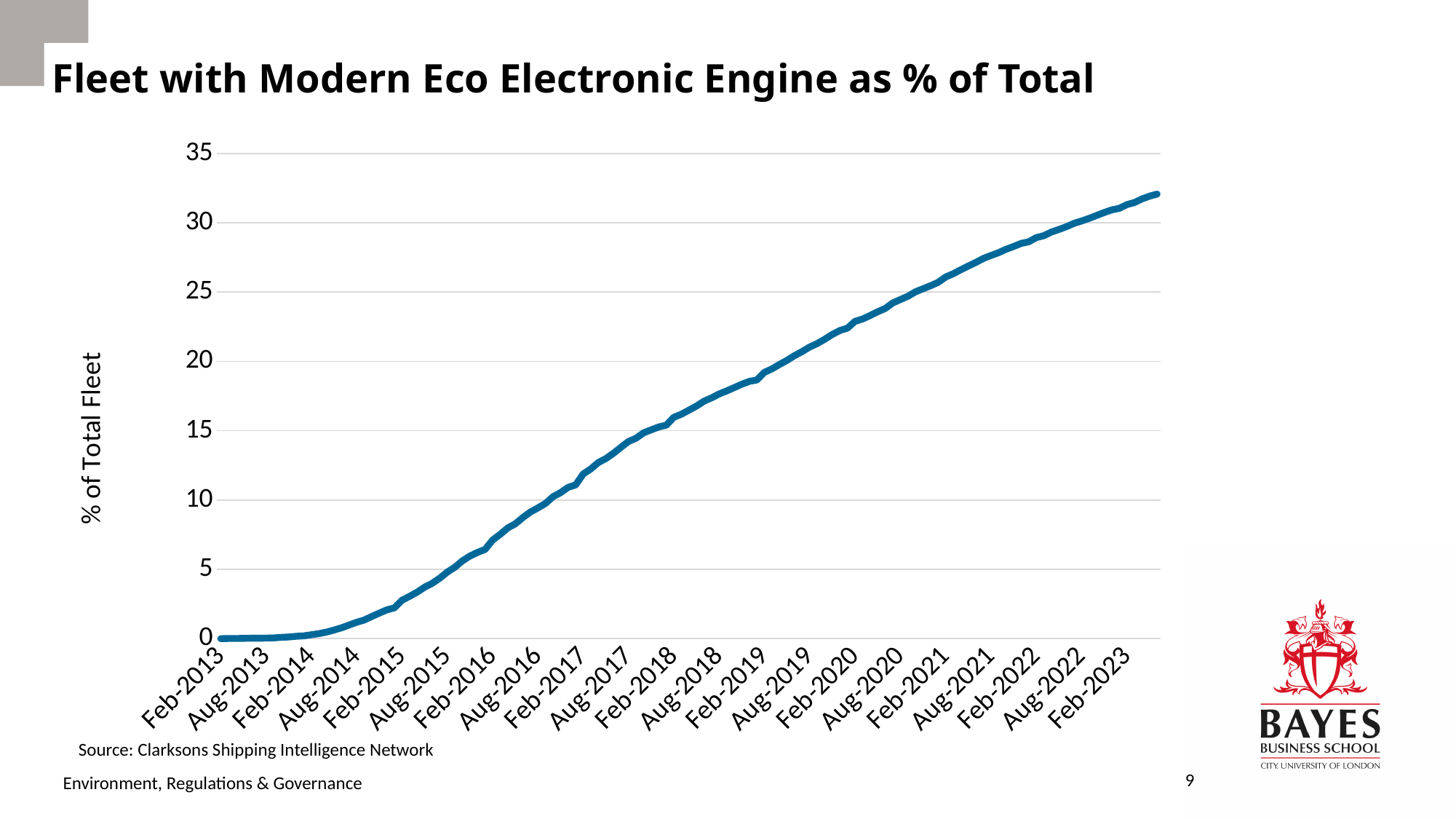
What is the label on the y axis of the chart? % of Total Fleet At which x-axis date is the plotted value highest? Feb-2023 At which x-axis date is the plotted value lowest? Feb-2013 Is the value for Aug-2017 greater or less than 15? less Which is larger, the value for Feb-2023 or the value for Feb-2018? Feb-2023 Is the value for Feb-2019 greater or less than 20? less Is the value for Feb-2020 greater or less than 20? greater Does the percentage of the fleet with a modern eco electronic engine rise or fall from Feb-2013 to Feb-2023? Rise What kind of chart is shown on the slide? Line chart